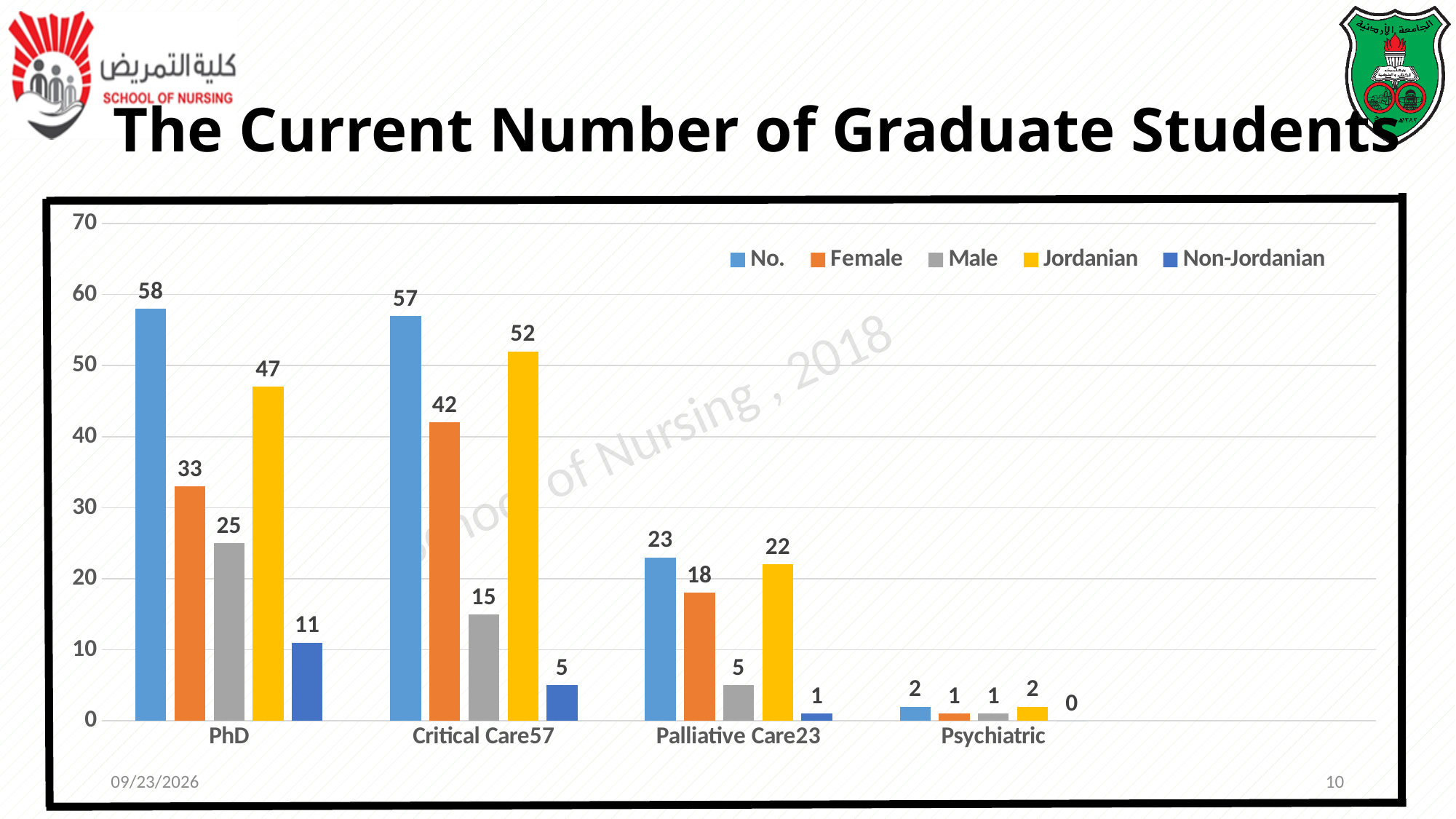
What is the difference between the Female and Male values for PhD? 8 What is the Jordanian value for Palliative Care23? 22 What is the title of the slide containing the chart? The Current Number of Graduate Students Which category has the highest No. value? PhD How many series does the legend list? 5 How many categories are shown on the x axis? 4 What is the Female value for the Critical Care57 category? 42 What is the value of the No. series for PhD? 58 What kind of chart is shown on the slide? Bar chart What is the Non-Jordanian value for Psychiatric? 0 Which is larger for Critical Care57: the Jordanian value or the Female value? Jordanian Which category has the lowest Male value? Psychiatric